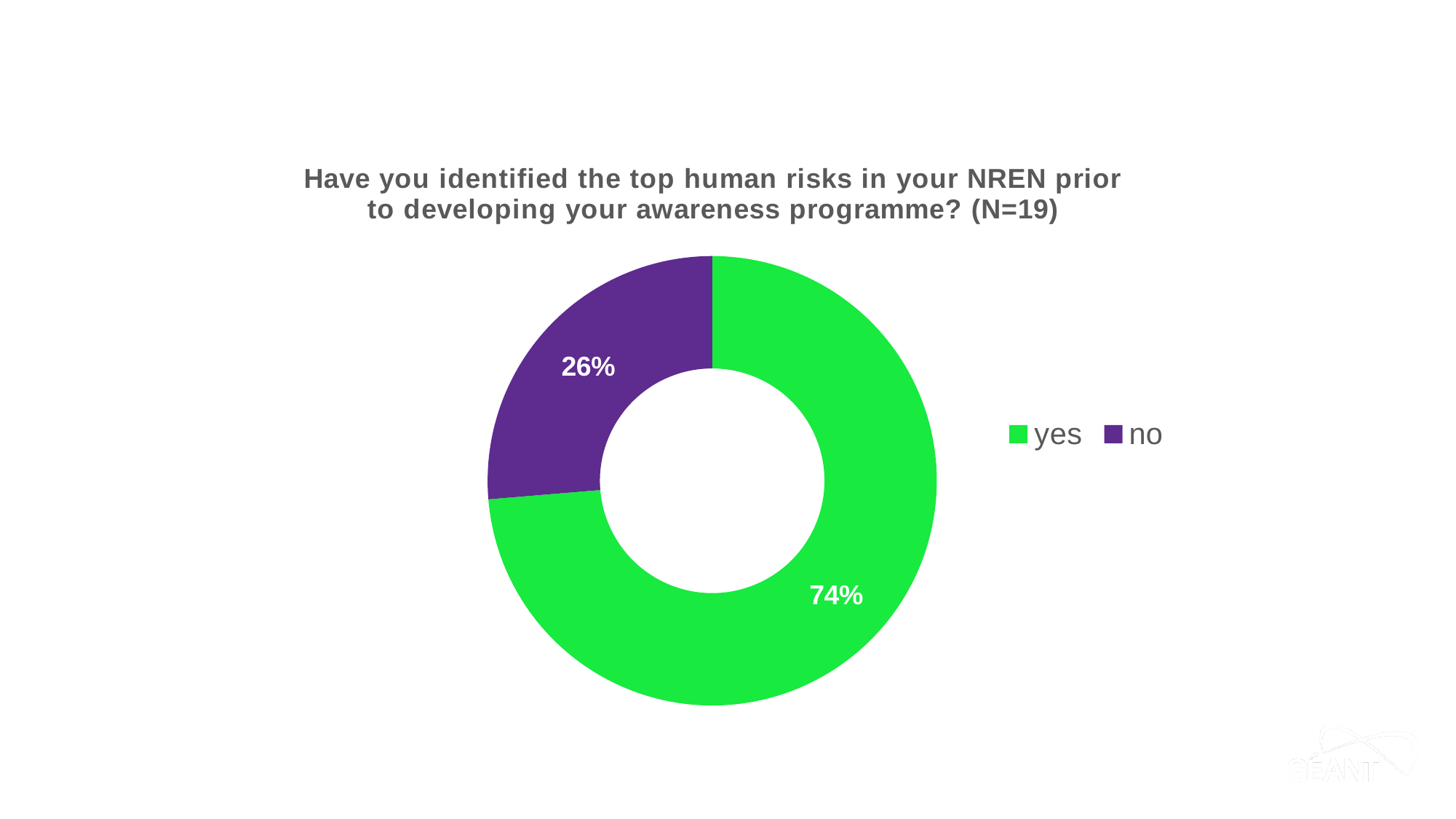
What percentage of respondents answered "yes"? 74% What kind of chart is shown on the slide? Doughnut (pie) chart Which response has the smallest share of the chart? no How many categories does the chart show? 2 How many respondents (N) does the chart title state? 19 What colour is the "yes" slice? Green Which response has the largest share of the chart? yes By how many percentage points does "yes" exceed "no"? 48 Which is larger, the share for "yes" or the share for "no"? yes What share of the chart does the "no" slice represent? 26% What percentage of respondents answered "no"? 26%